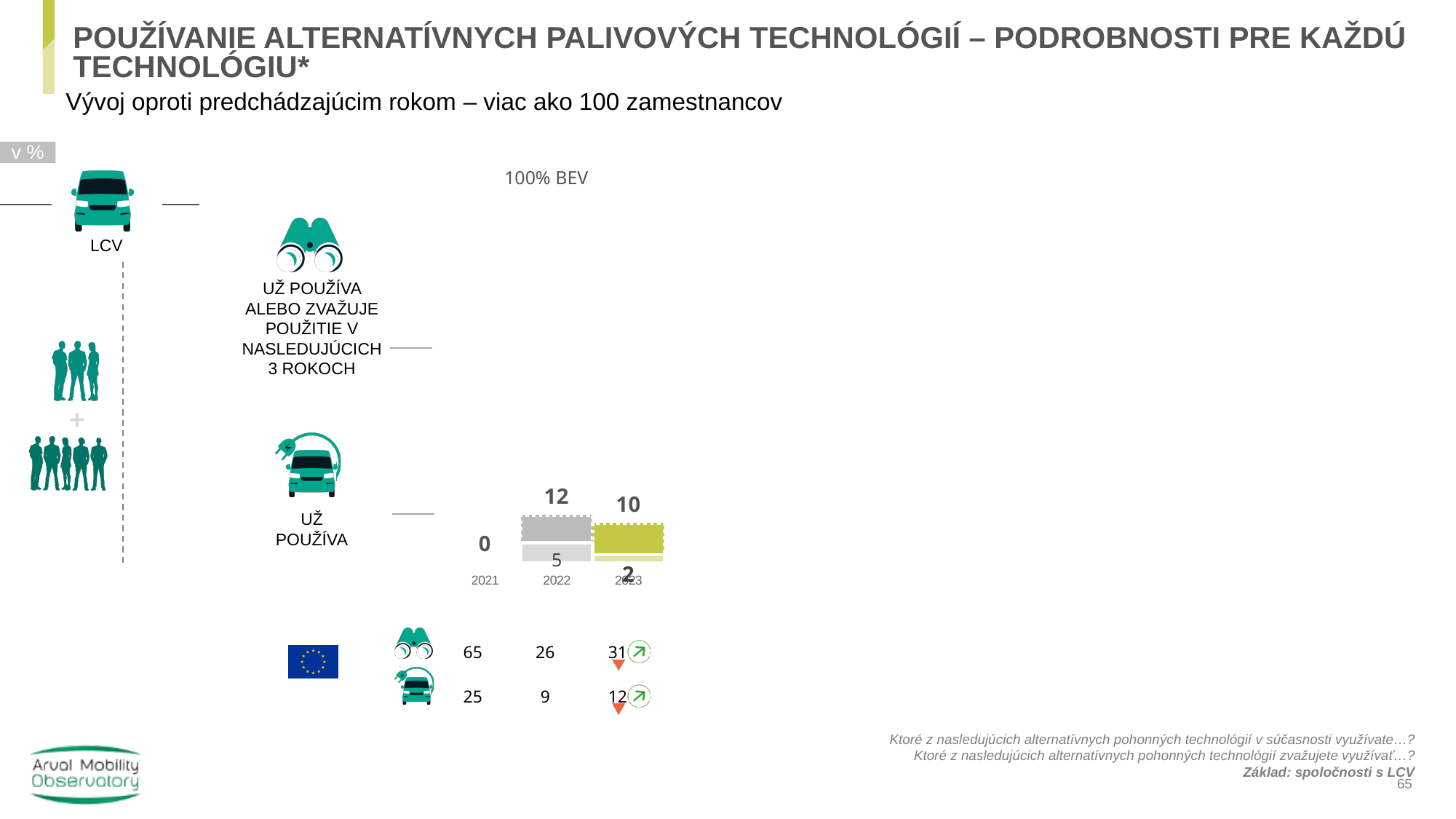
In the 100% BEV chart, what is the value for 2023 for 'už používa alebo zvažuje použitie v nasledujúcich 3 rokoch'? 10 In the 100% BEV chart, what is the difference between the 2022 and 2023 values for 'už používa alebo zvažuje použitie v nasledujúcich 3 rokoch'? 2 In the 100% BEV chart, what is the 'už používa' value for 2023? 2 How many years are shown on the x axis of the 100% BEV chart? 3 In the 100% BEV chart, which year has the highest value for 'už používa alebo zvažuje použitie v nasledujúcich 3 rokoch'? 2022 In the 100% BEV chart, do the 'už používa' values rise or fall from 2022 to 2023? fall In the 100% BEV chart, what is the 'už používa' value for 2022? 5 In the 100% BEV chart, which year has the larger 'už používa' value, 2022 or 2023? 2022 What kind of chart is the 100% BEV chart? bar chart In the 100% BEV chart, what is the value for 2022 for 'už používa alebo zvažuje použitie v nasledujúcich 3 rokoch'? 12 In the 100% BEV chart, what value is shown for 2021? 0 In the 100% BEV chart, what is the difference between the 2022 and 2023 'už používa' values? 3